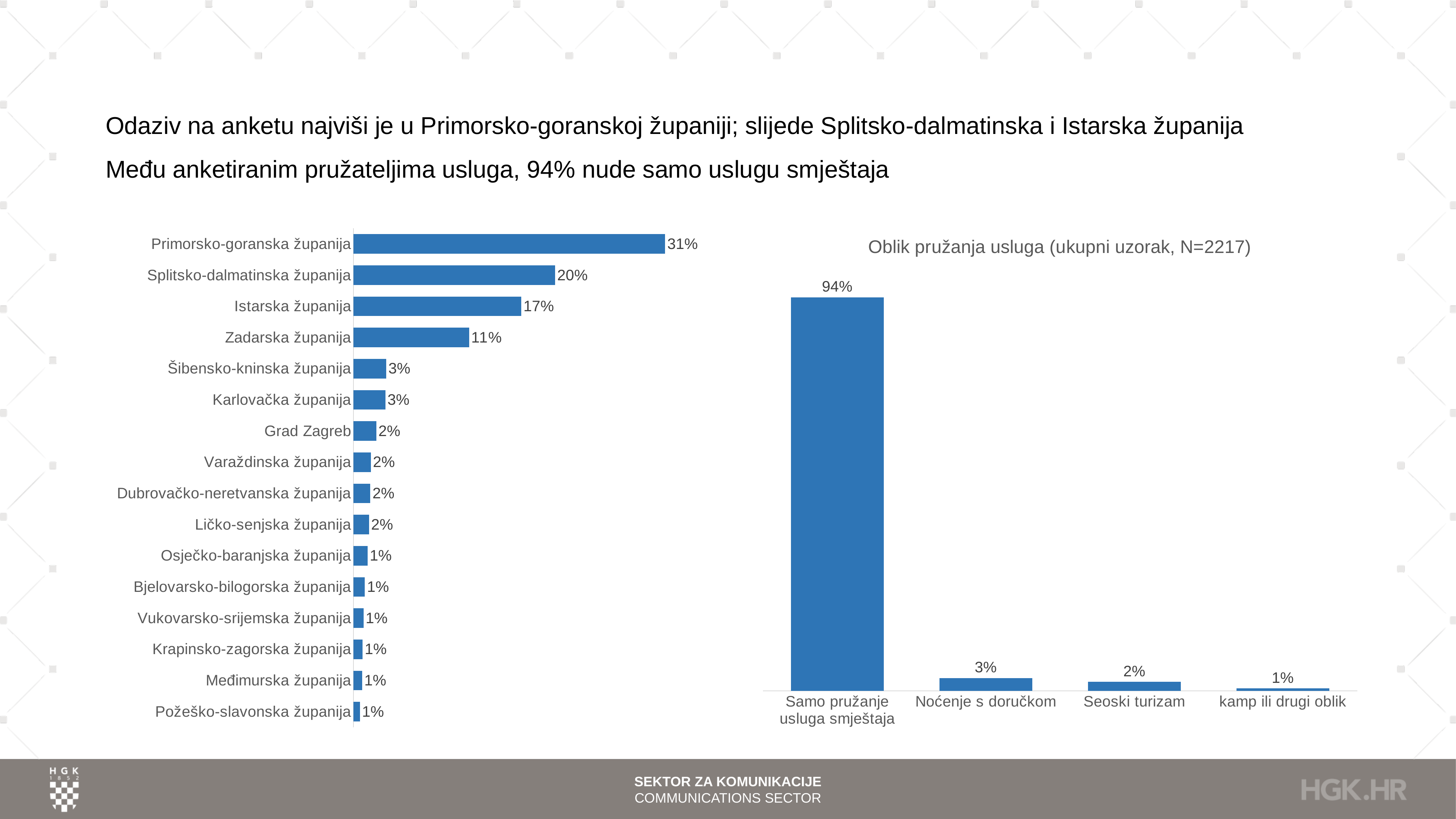
In the chart titled 'Oblik pružanja usluga (ukupni uzorak, N=2217)', which category has the lowest value? kamp ili drugi oblik In the left chart of counties, how many counties are listed? 16 In the left chart of counties, what is the value for Primorsko-goranska županija? 31% In the chart titled 'Oblik pružanja usluga (ukupni uzorak, N=2217)', what is the value for Noćenje s doručkom? 3% In the left chart of counties, what kind of chart is it? Bar chart In the left chart of counties, which is larger, Istarska županija or Zadarska županija? Istarska županija In the left chart of counties, what is the value for Zadarska županija? 11% In the chart titled 'Oblik pružanja usluga (ukupni uzorak, N=2217)', what is the difference between Samo pružanje usluga smještaja and Seoski turizam? 92% In the left chart of counties, what is the difference between Splitsko-dalmatinska županija and Istarska županija? 3% In the chart titled 'Oblik pružanja usluga (ukupni uzorak, N=2217)', how many categories are shown? 4 In the left chart of counties, which county has the highest value? Primorsko-goranska županija In the chart titled 'Oblik pružanja usluga (ukupni uzorak, N=2217)', what is the value for Samo pružanje usluga smještaja? 94%